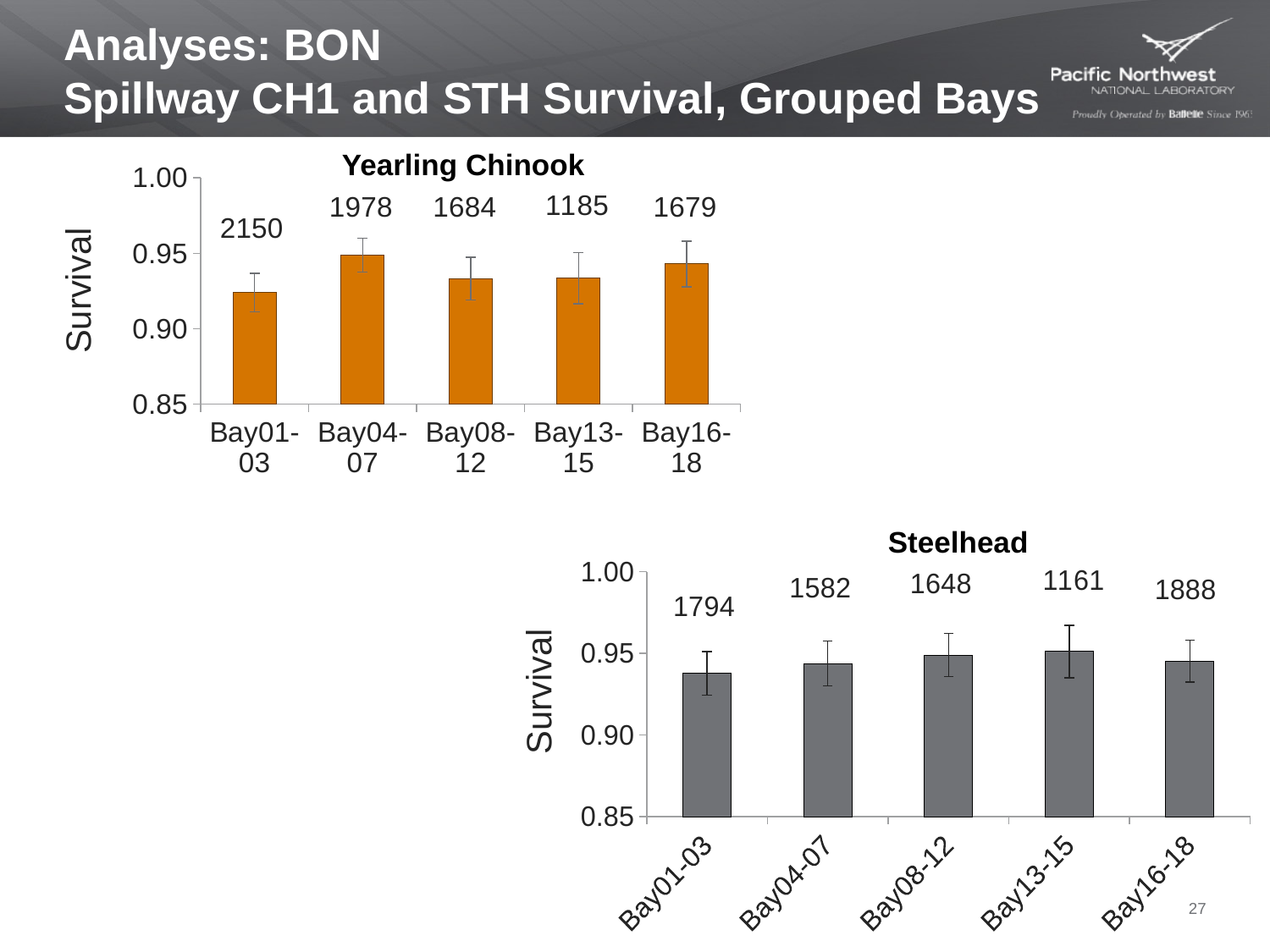
On the Yearling Chinook chart, what number is printed above the Bay01-03 bar? 2150 On the Steelhead chart, which bay group has the smallest number printed above its bar? Bay13-15 On the Steelhead chart, is the survival for Bay01-03 greater or less than 0.90? greater On the Yearling Chinook chart, is the survival for Bay13-15 greater or less than 0.95? less On the Steelhead chart, what number is printed above the Bay16-18 bar? 1888 On the Yearling Chinook chart, what is the difference between the numbers printed above the Bay01-03 and Bay04-07 bars? 172 On the Yearling Chinook chart, which bay group has the lowest survival? Bay01-03 On the Steelhead chart, which bay group has the lowest survival? Bay01-03 On the Yearling Chinook chart, what number is printed above the Bay13-15 bar? 1185 What is the y-axis label on the Steelhead chart? Survival What kind of chart is the Yearling Chinook chart? bar chart How many bay groups are shown on the Steelhead chart? 5